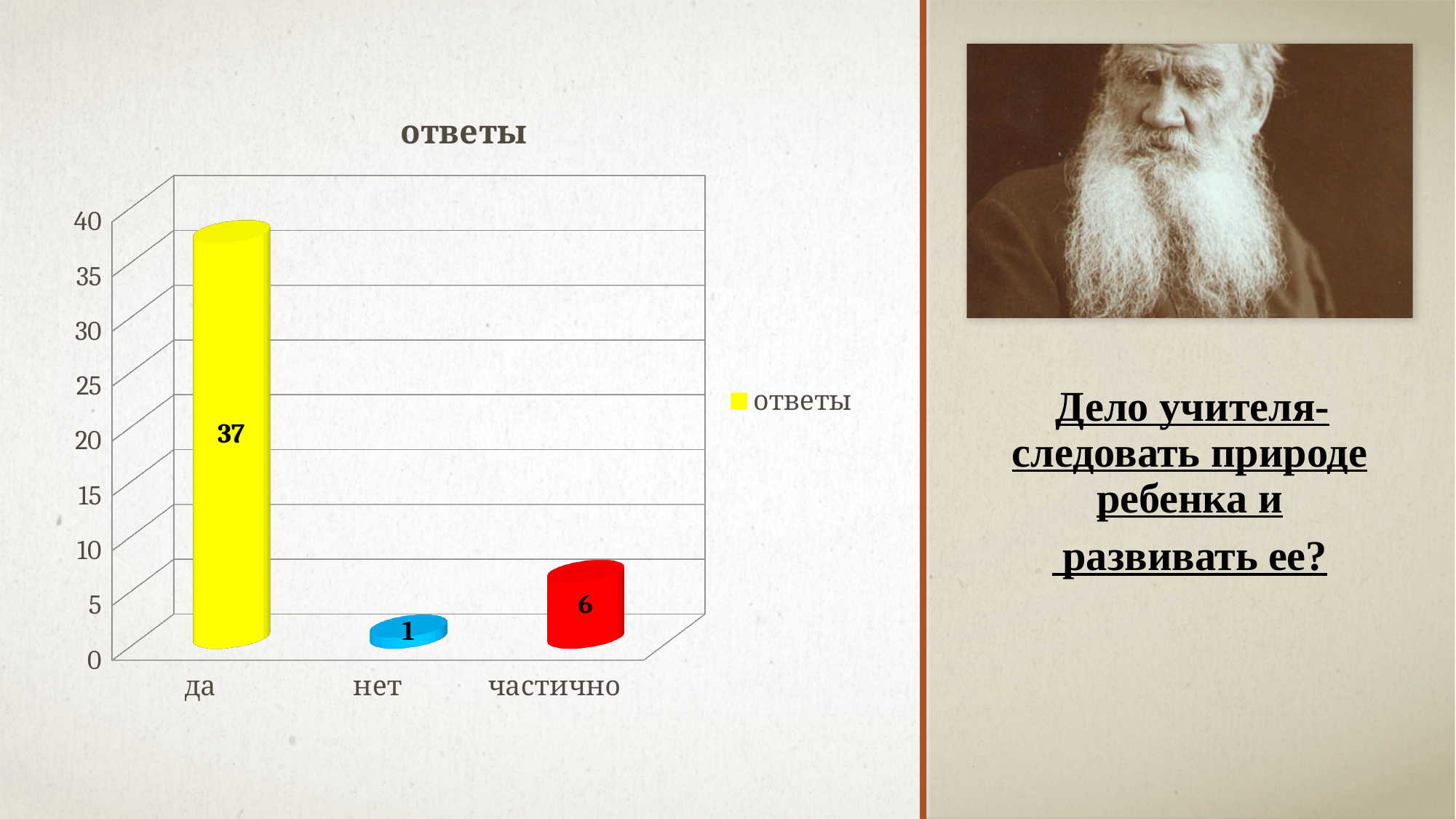
What is the difference between the values for "да" and "частично"? 31 Which category has the lowest value? нет Is the value for "да" greater or less than 35? greater Which category has the highest value? да What is the value for "частично"? 6 How many categories are shown on the x axis? 3 What is the difference between the values for "частично" and "нет"? 5 Which is larger, the value for "нет" or the value for "частично"? частично What is the value for "да"? 37 What is the title of the chart? ответы What kind of chart is shown on the slide? bar chart What is the value for "нет"? 1